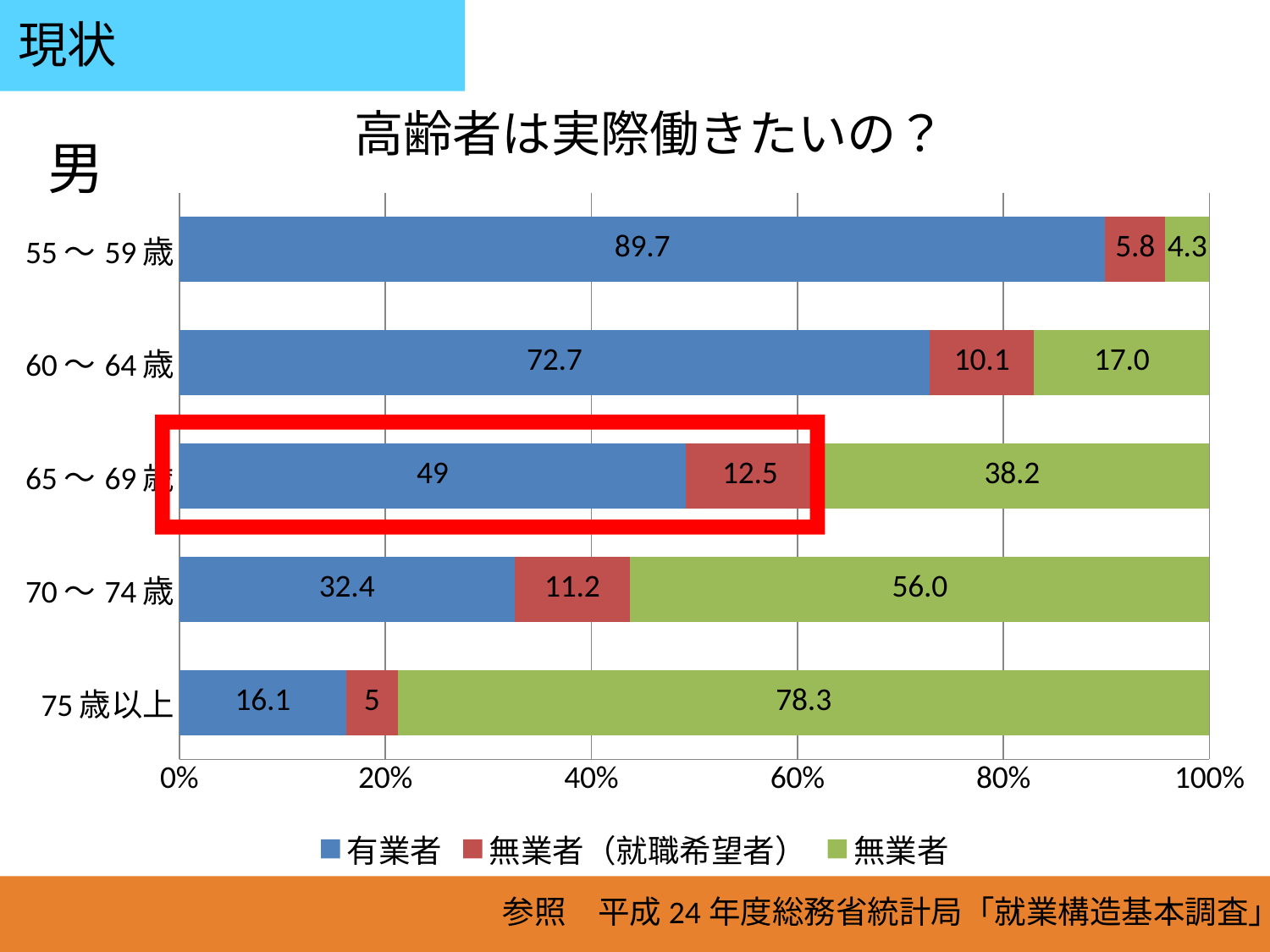
Does the 有業者 value rise or fall as the age categories go from 55～59歳 to 75歳以上? Fall What is the value of 無業者（就職希望者） for the 60～64歳 category? 10.1 What kind of chart is shown on the slide? Stacked bar chart How many series does the legend list? 3 What is the difference between the 有業者 values for 55～59歳 and 60～64歳? 17.0 How many age categories are shown on the chart? 5 Which age category has the lowest 無業者 value? 55～59歳 Which age category has the highest 有業者 value? 55～59歳 What is the value of 無業者 for the 75歳以上 category? 78.3 What is the value of 有業者 for the 65～69歳 category? 49 What is the title of the chart? 高齢者は実際働きたいの？ Which is larger: the 無業者 value for 70～74歳 or for 65～69歳? 70～74歳